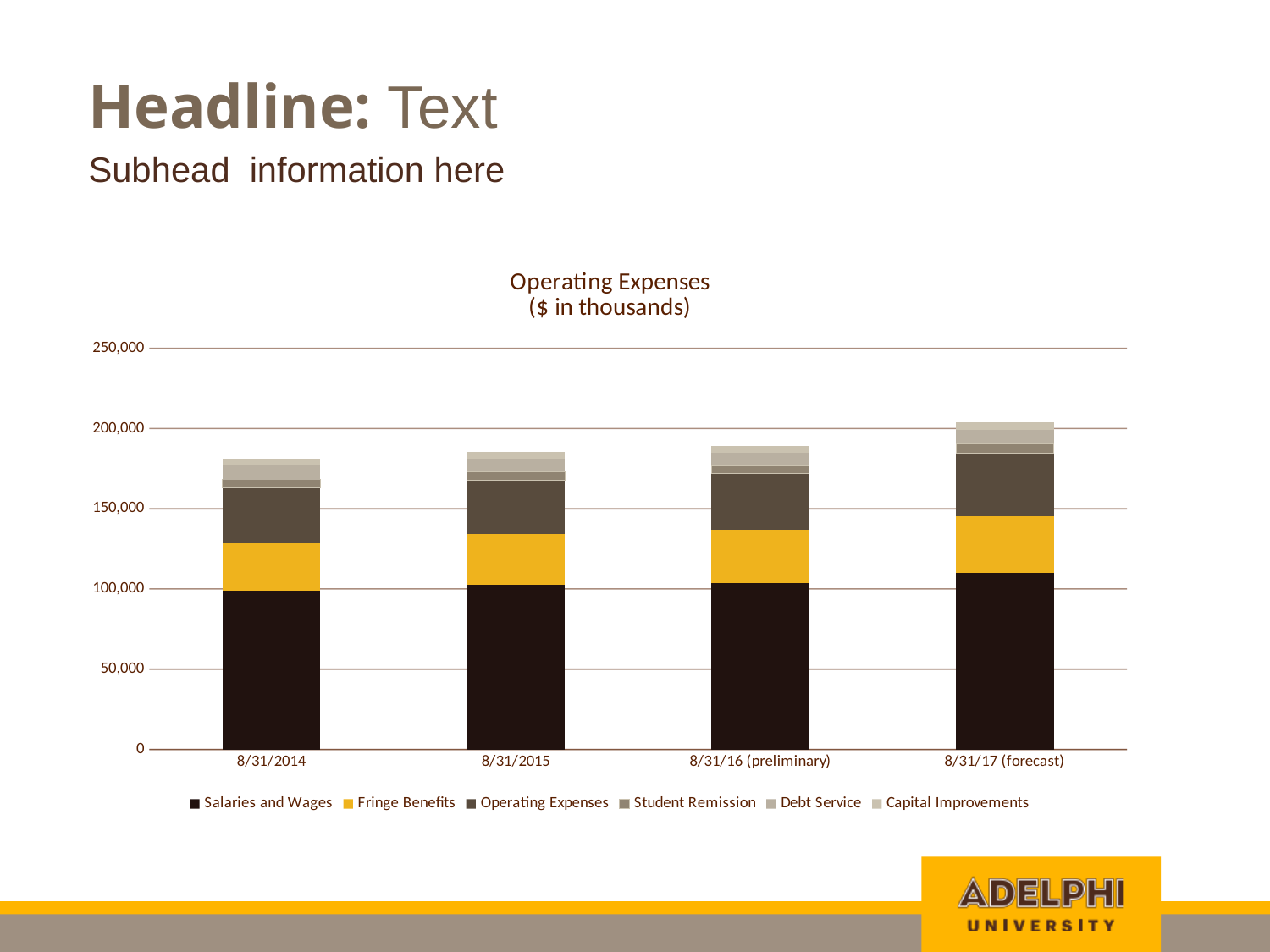
How many categories (dates) are shown on the x axis of the chart? 4 Which category has the highest total operating expenses? 8/31/17 (forecast) What is the title of the chart? Operating Expenses ($ in thousands) Is the Salaries and Wages value for 8/31/17 (forecast) greater or less than 100,000? greater Which is larger, the total for 8/31/2015 or the total for 8/31/16 (preliminary)? 8/31/16 (preliminary) Is the total for 8/31/2015 greater or less than 150,000? greater How many series does the chart's legend list? 6 What kind of chart is shown on the slide? stacked bar chart Do the total operating expenses rise or fall from 8/31/2014 to 8/31/17 (forecast)? rise Which category has the lowest total operating expenses? 8/31/2014 Which series is listed first in the chart's legend? Salaries and Wages Is the total for 8/31/2014 greater or less than 200,000? less